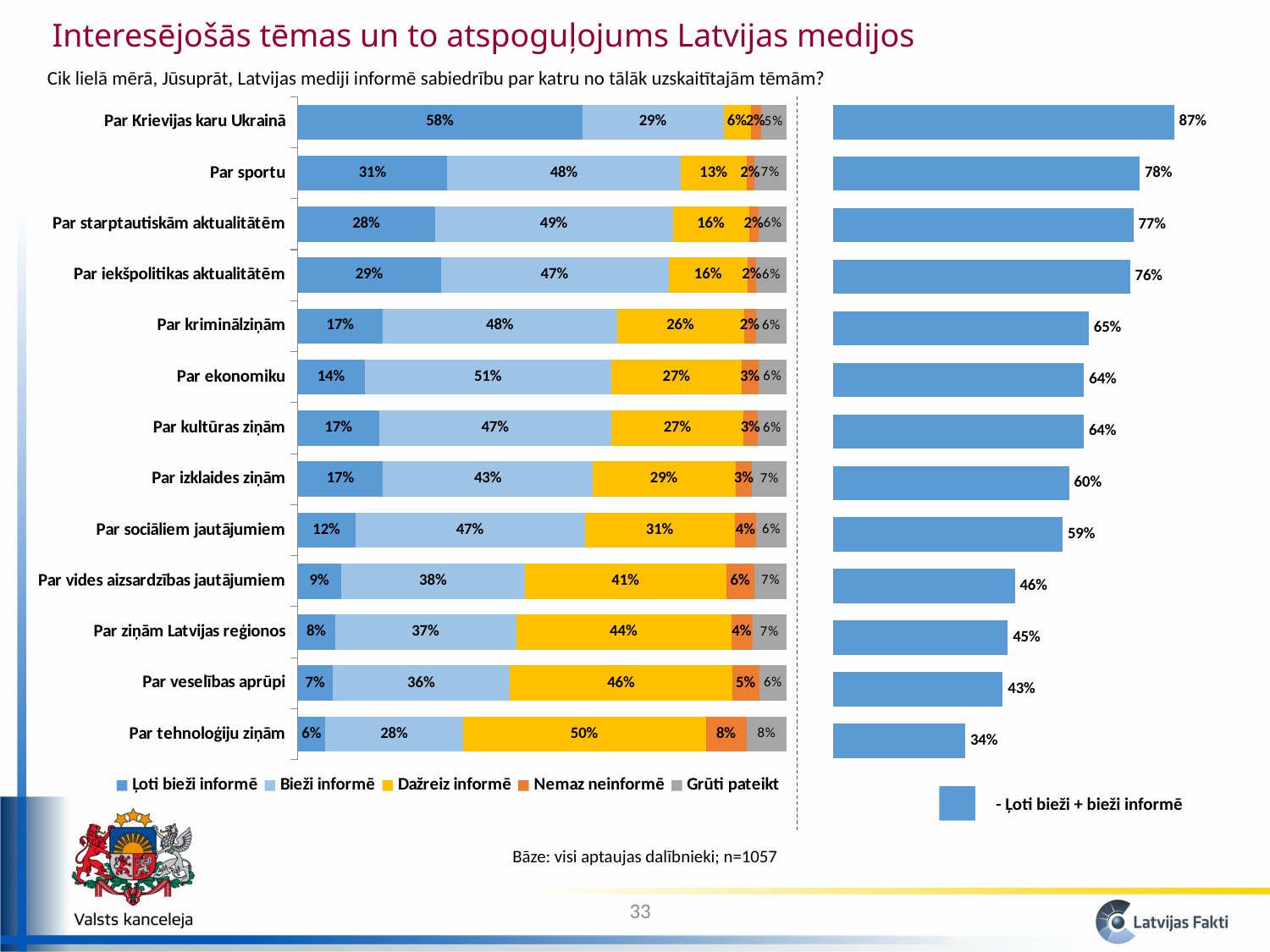
How many categories are shown in the stacked bar chart on the left? 13 In the bar chart on the right ('Ļoti bieži + bieži informē'), what is the difference between the values for 'Par sportu' and 'Par ekonomiku'? 14% In the bar chart on the right ('Ļoti bieži + bieži informē'), which category has the lowest value? Par tehnoloģiju ziņām In the stacked bar chart on the left, what is the 'Dažreiz informē' value for 'Par tehnoloģiju ziņām'? 50% In the bar chart on the right ('Ļoti bieži + bieži informē'), what is the value for 'Par veselības aprūpi'? 43% In the stacked bar chart on the left, what is the total of the 'Ļoti bieži informē' and 'Bieži informē' segments for 'Par sociāliem jautājumiem'? 59% What kind of chart is the chart on the right of the slide? Bar chart In the stacked bar chart on the left, which is larger: the 'Bieži informē' value for 'Par ekonomiku' or for 'Par vides aizsardzības jautājumiem'? Par ekonomiku How many series does the legend of the stacked bar chart on the left list? 5 In the stacked bar chart on the left, what is the 'Ļoti bieži informē' value for 'Par Krievijas karu Ukrainā'? 58% What does the legend of the bar chart on the right say the bars represent? Ļoti bieži + bieži informē In the bar chart on the right ('Ļoti bieži + bieži informē'), which category has the highest value? Par Krievijas karu Ukrainā